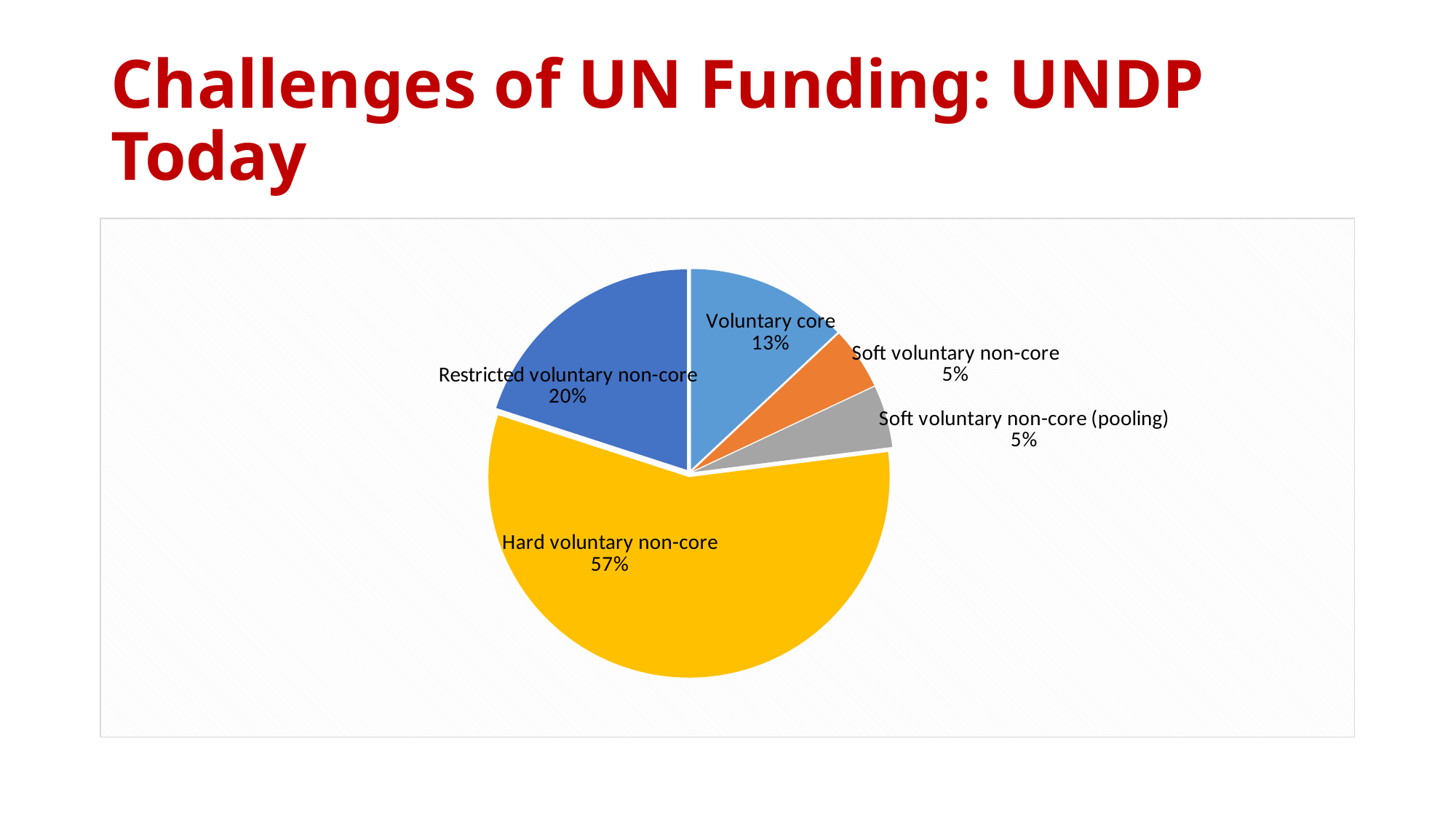
What share of the pie does Voluntary core represent? 13% What is the difference in percentage points between Hard voluntary non-core and Restricted voluntary non-core? 37 What is the title of the slide containing the pie chart? Challenges of UN Funding: UNDP Today What colour is the Hard voluntary non-core slice? Yellow What type of chart is shown on the slide? Pie chart What share of the pie does Hard voluntary non-core represent? 57% Which category has the largest slice of the pie? Hard voluntary non-core How many slices does the pie chart have? 5 Which is larger, Voluntary core or Soft voluntary non-core? Voluntary core What is the difference in percentage points between Restricted voluntary non-core and Voluntary core? 7 What share of the pie does Soft voluntary non-core (pooling) represent? 5%